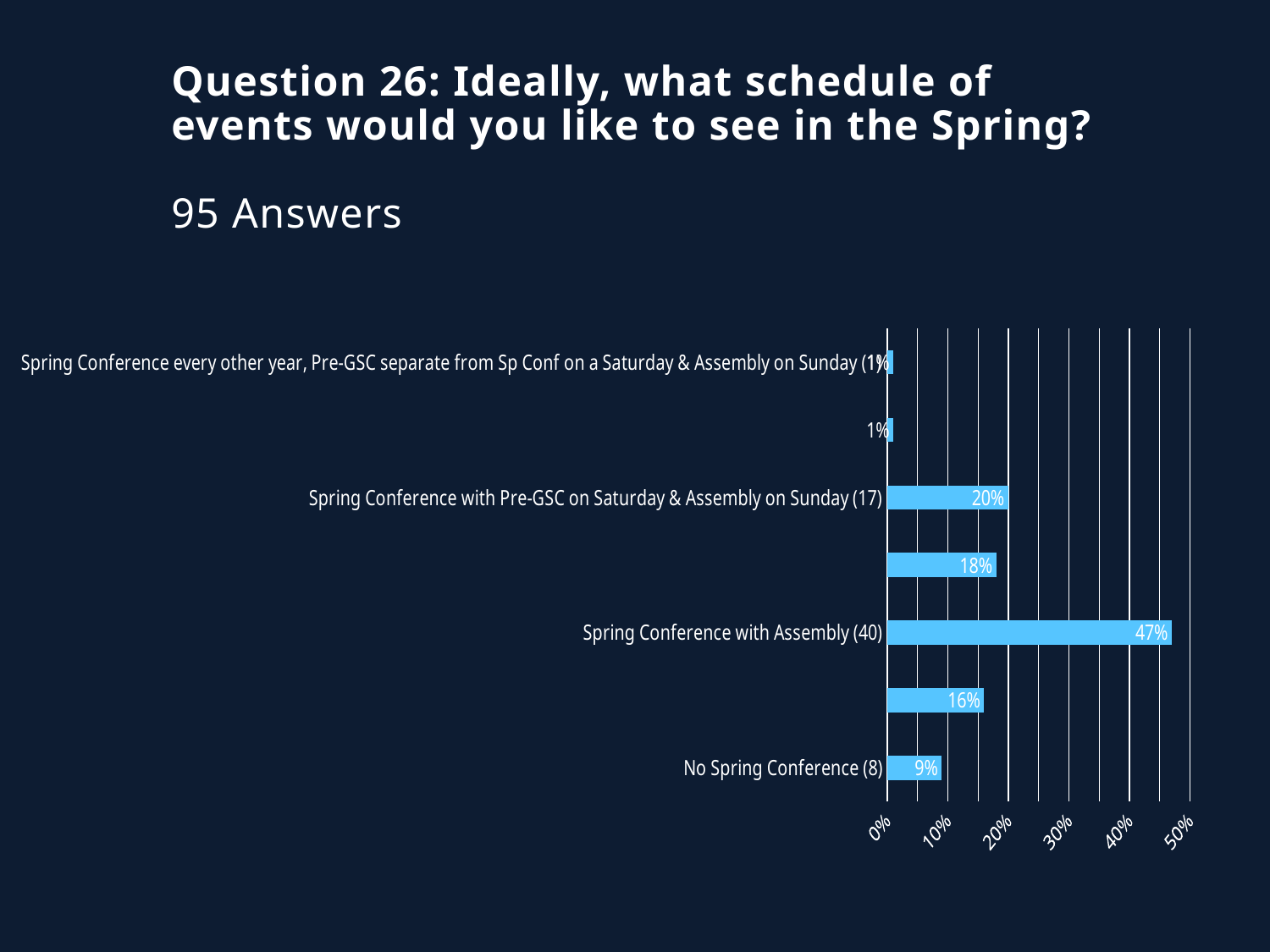
What percentage is shown for "Spring Conference every other year, Pre-GSC separate from Sp Conf on a Saturday & Assembly on Sunday (1)"? 1% What percentage of respondents chose "Spring Conference with Assembly (40)"? 47% What percentage of respondents chose "Spring Conference with Pre-GSC on Saturday & Assembly on Sunday (17)"? 20% What is the smallest percentage value shown on the chart? 1% What is the difference in percentage points between "Spring Conference with Pre-GSC on Saturday & Assembly on Sunday (17)" and "No Spring Conference (8)"? 11% How many bars are plotted on the chart? 7 What is the difference in percentage points between "Spring Conference with Assembly (40)" and "Spring Conference with Pre-GSC on Saturday & Assembly on Sunday (17)"? 27% Which option received the highest percentage of responses? Spring Conference with Assembly (40) What percentage of respondents chose "No Spring Conference (8)"? 9% Is the value for "No Spring Conference (8)" greater or less than 10%? less What type of chart is shown on the slide? Bar chart Which received a larger share of responses: "Spring Conference with Assembly (40)" or "No Spring Conference (8)"? Spring Conference with Assembly (40)